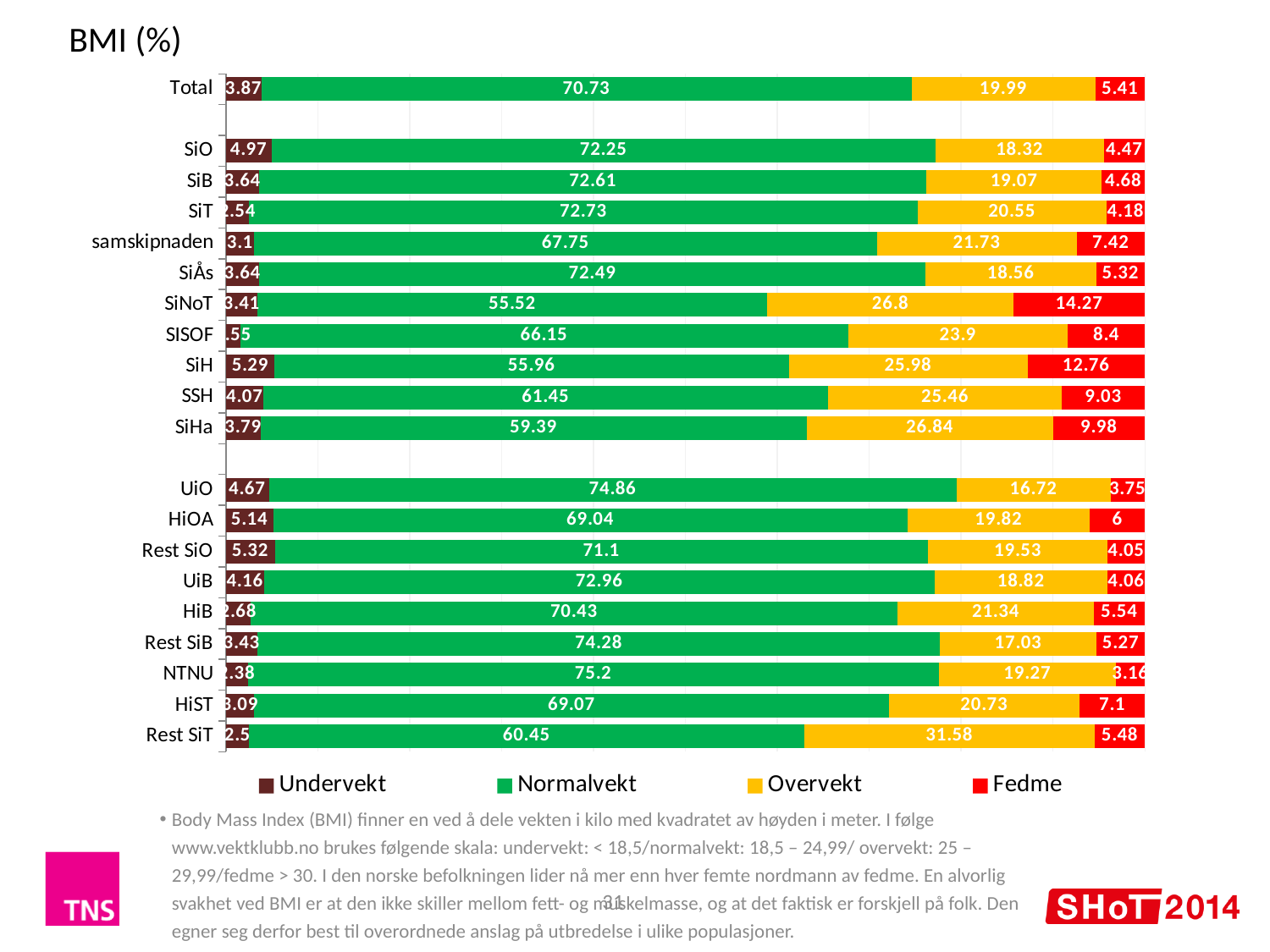
What is the Normalvekt value for Total? 70.73 What is the Overvekt value for Rest SiT? 31.58 Which has the larger Normalvekt value, UiO or HiOA? UiO What is the Undervekt value for HiOA? 5.14 What is the Fedme value for SiNoT? 14.27 Which category has the highest Normalvekt value? NTNU How many series does the legend list? 4 What is the difference between the Fedme values for SiNoT and SiH? 1.51 What kind of chart is shown on the slide? Stacked bar chart How many categories are shown on the y axis? 20 Which category has the highest Fedme value? SiNoT Which category has the lowest Normalvekt value? SiNoT